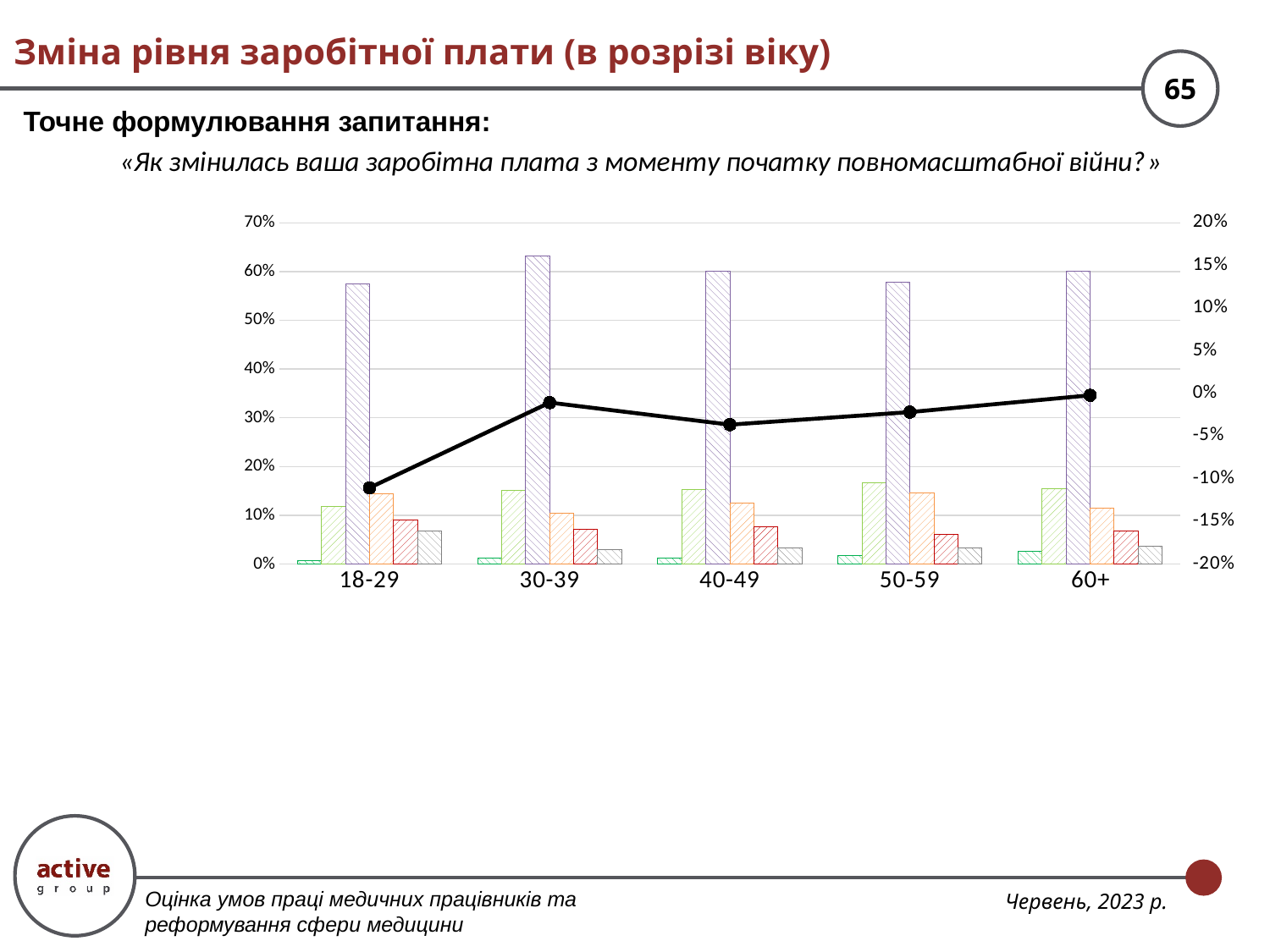
Is the tallest bar in the 18-29 group greater or less than 50%? greater Which age group has the tallest bar in the chart? 30-39 Is the tallest bar in the 50-59 group greater or less than 50%? greater How many bars are plotted for each age group in the chart? 6 For which age group is the black line at its lowest point? 18-29 Is the black line value for 40-49 greater or less than 0% on the right axis? less Does the black line rise or fall from 18-29 to 30-39? rise What is the range of the right-hand axis of the chart? -20% to 20% How many age groups are shown on the x axis of the chart? 5 What kind of chart is shown on the slide? bar chart combined with a line